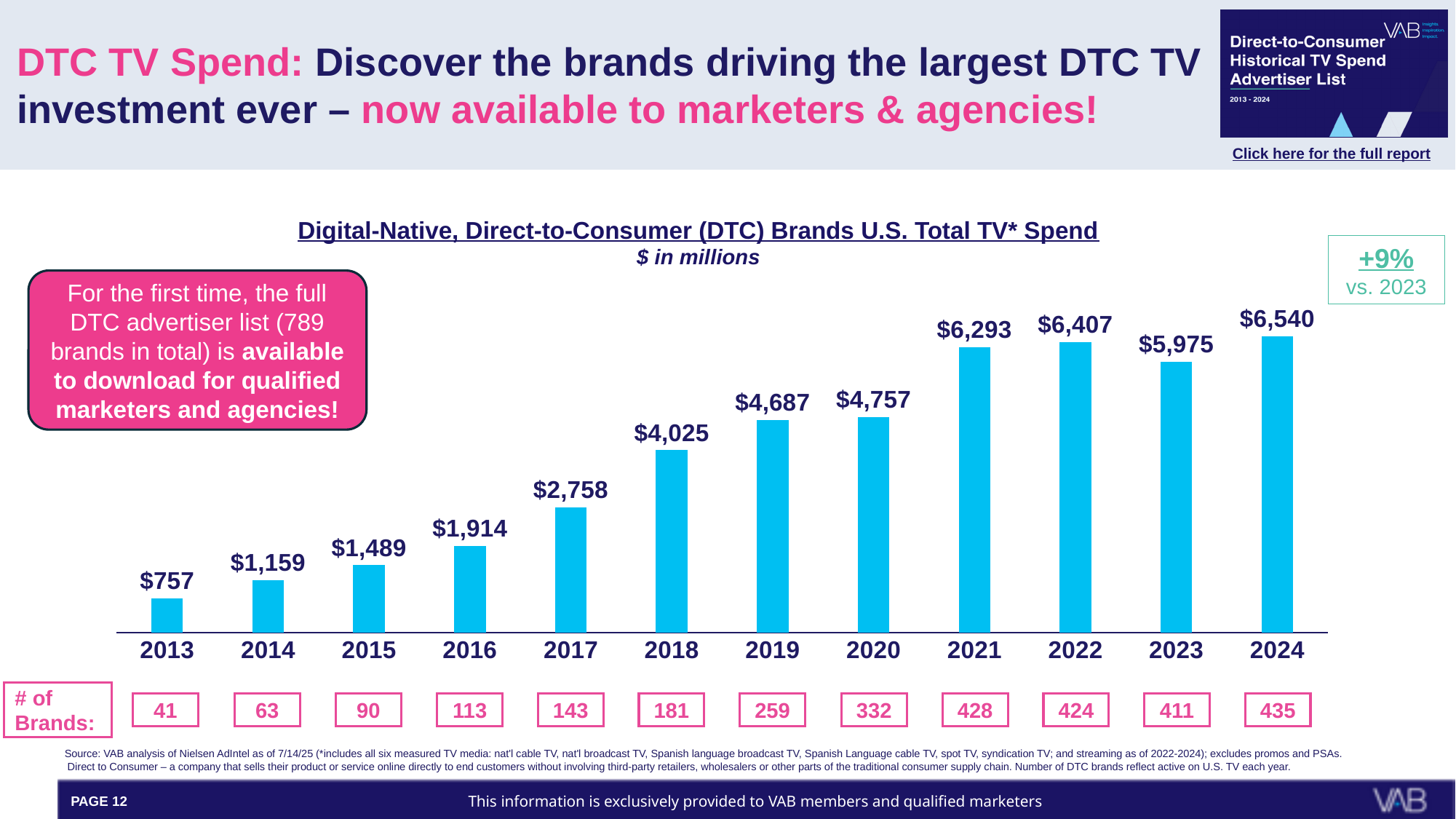
What is the DTC brands U.S. total TV spend for 2024? $6,540 What is the DTC brands U.S. total TV spend for 2013? $757 In what unit is the DTC TV spend shown on the chart? $ in millions What is the difference in DTC TV spend between 2024 and 2023? $565 What is the difference in DTC TV spend between 2022 and 2021? $114 What is the DTC brands U.S. total TV spend for 2019? $4,687 Which year has a higher DTC TV spend, 2022 or 2023? 2022 What kind of chart is used to show DTC TV spend? Bar chart Which year has the highest DTC TV spend? 2024 Does DTC TV spend generally rise or fall from 2013 to 2024? Rise How many years are shown on the chart? 12 Which year has the lowest DTC TV spend? 2013